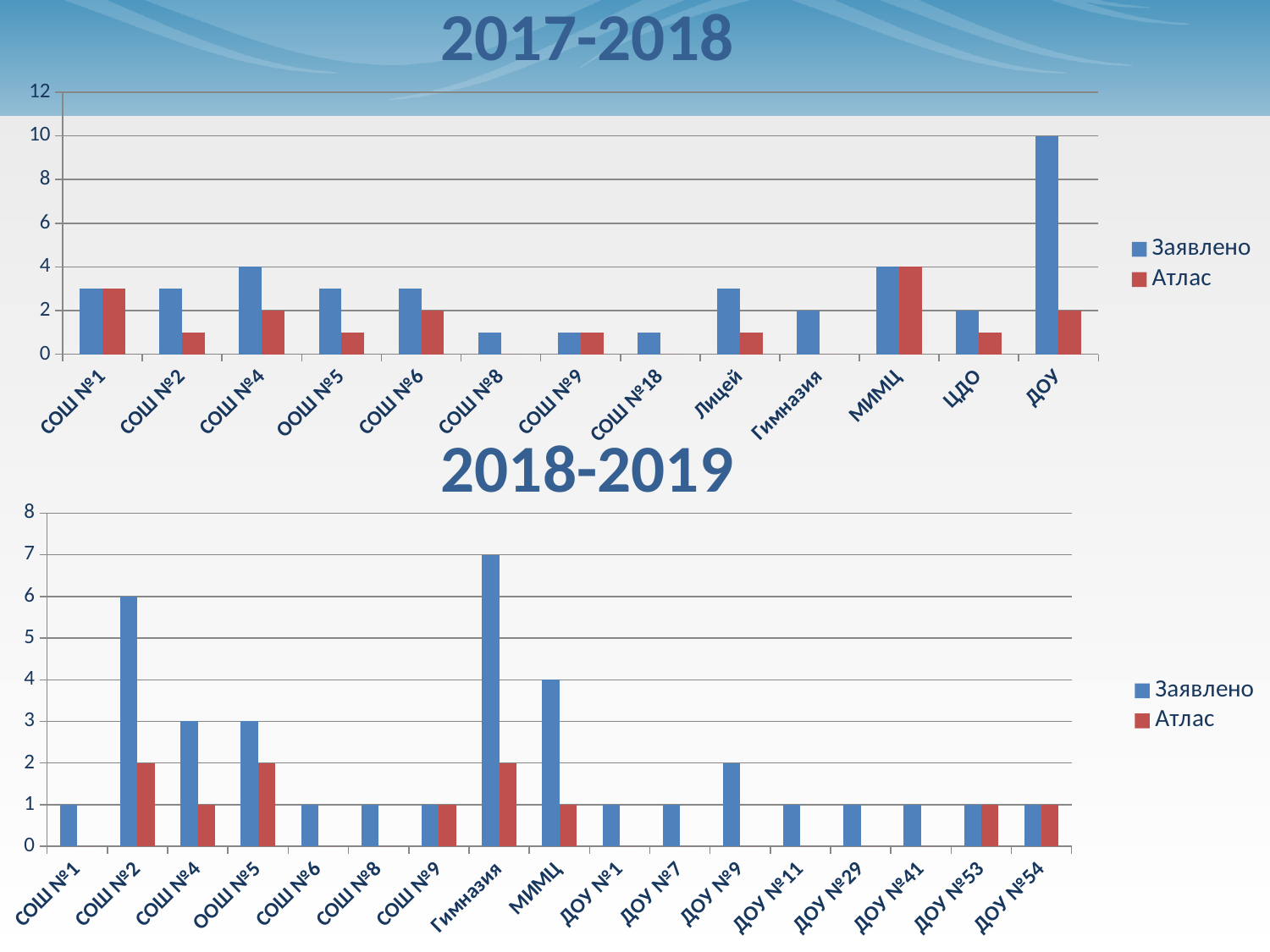
In the 2017-2018 chart, what is the Атлас value for МИМЦ? 4 In the 2018-2019 chart, which category has the highest Заявлено value? Гимназия How many series does the legend of the 2018-2019 chart list? 2 In the 2017-2018 chart, which category has the highest Заявлено value? ДОУ In the 2017-2018 chart, how many categories are shown on the x axis? 13 In the 2017-2018 chart, is the Заявлено value for ДОУ greater or less than 8? greater What type of chart is the 2017-2018 chart? Bar chart In the 2018-2019 chart, what is the Заявлено value for СОШ №2? 6 In the 2018-2019 chart, which is larger: the Заявлено value for МИМЦ or the Заявлено value for ДОУ №9? МИМЦ In the 2017-2018 chart, what is the difference between the Заявлено and Атлас values for СОШ №4? 2 In the 2018-2019 chart, how many categories are shown on the x axis? 17 In the 2017-2018 chart, what is the Заявлено value for ДОУ? 10